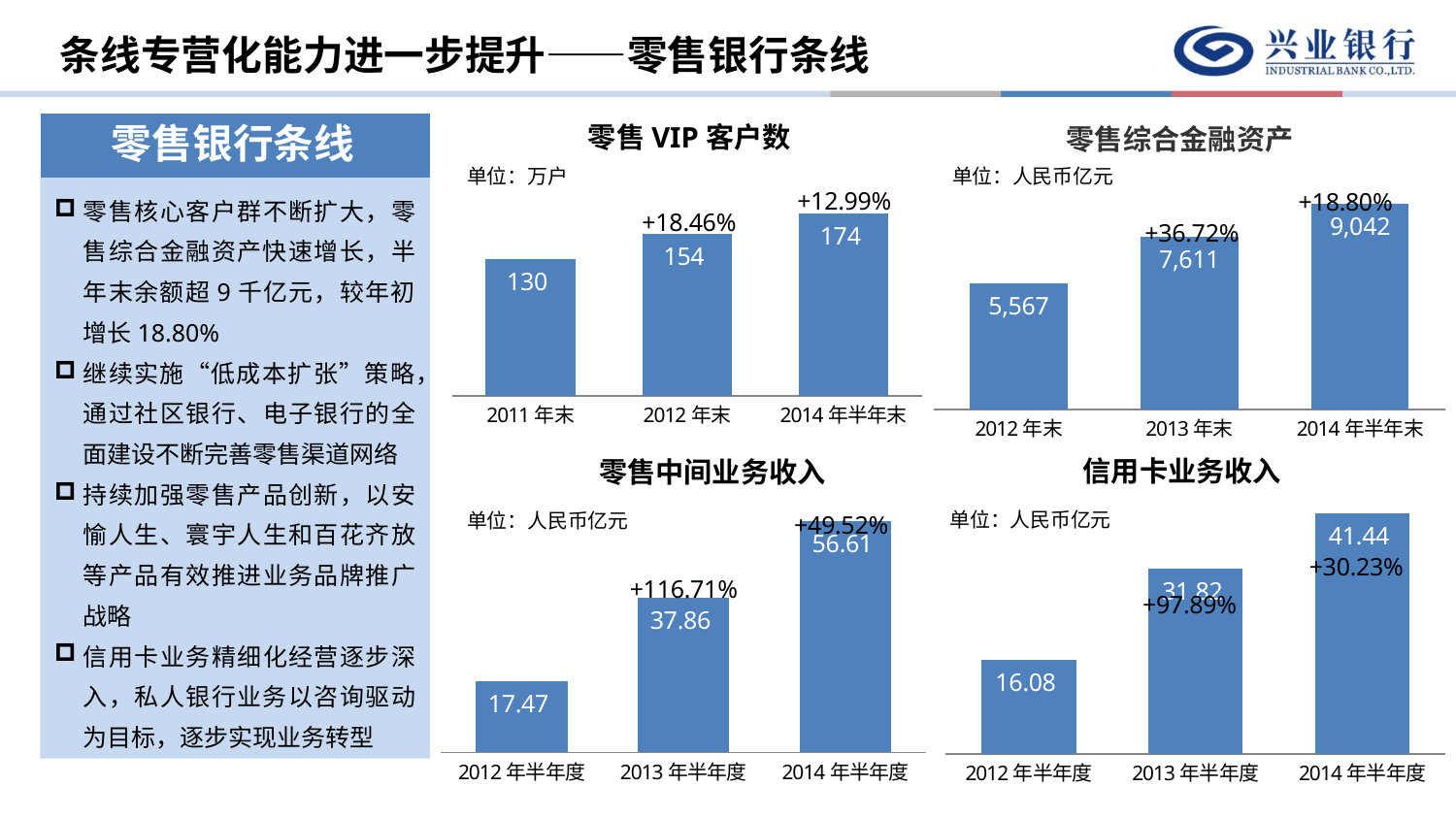
In the 零售中间业务收入 chart, which category has the highest value? 2014 年半年度 How many categories are shown in the 零售 VIP 客户数 chart? 3 In the 零售综合金融资产 chart, what growth percentage is shown above the 2013 年末 bar? +36.72% What type of chart is the 信用卡业务收入 chart? bar chart In the 零售 VIP 客户数 chart, what is the difference between the 2014 年半年末 value and the 2011 年末 value? 44 In the 零售 VIP 客户数 chart, what is the value for 2012 年末? 154 In the 零售中间业务收入 chart, what growth percentage is shown above the 2013 年半年度 bar? +116.71% In the 零售中间业务收入 chart, what is the value for 2012 年半年度? 17.47 In the 零售综合金融资产 chart, what is the value for 2014 年半年末? 9,042 In the 信用卡业务收入 chart, is the value for 2012 年半年度 larger or smaller than the value for 2014 年半年度? smaller In the 零售综合金融资产 chart, which category has the lowest value? 2012 年末 In the 信用卡业务收入 chart, what is the value for 2014 年半年度? 41.44